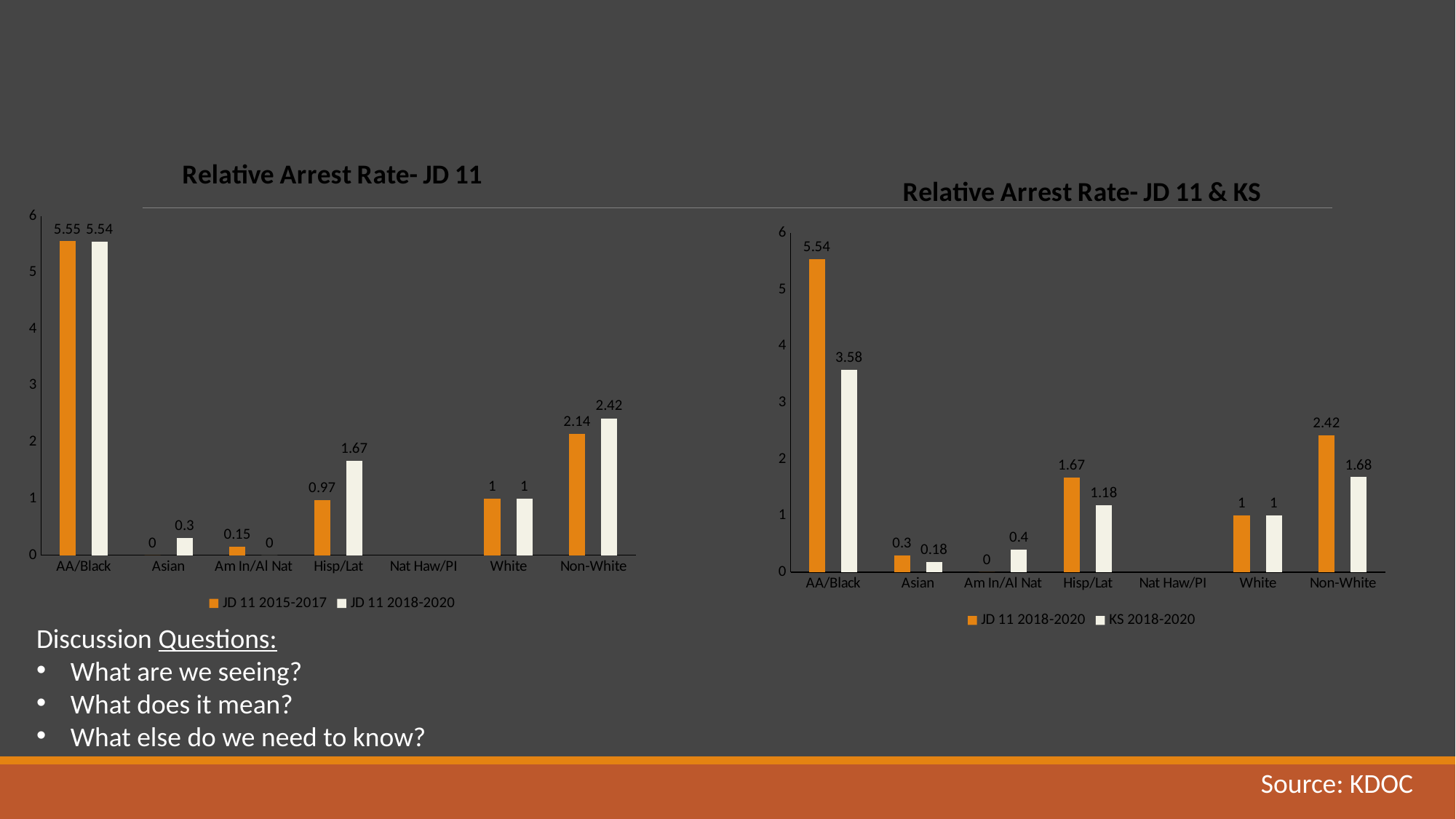
In the 'Relative Arrest Rate- JD 11' chart, how many categories are shown on the x axis? 7 In the 'Relative Arrest Rate- JD 11' chart, what is the value for Hisp/Lat in the JD 11 2018-2020 series? 1.67 In the 'Relative Arrest Rate- JD 11 & KS' chart, which is larger for Non-White: JD 11 2018-2020 or KS 2018-2020? JD 11 2018-2020 What kind of chart is 'Relative Arrest Rate- JD 11 & KS'? Bar chart In the 'Relative Arrest Rate- JD 11' chart, what is the value for AA/Black in the JD 11 2015-2017 series? 5.55 In the 'Relative Arrest Rate- JD 11 & KS' chart, what is the difference between the JD 11 2018-2020 and KS 2018-2020 values for Hisp/Lat? 0.49 In the 'Relative Arrest Rate- JD 11' chart, how many series does the legend list? 2 In the 'Relative Arrest Rate- JD 11 & KS' chart, what is the value for Am In/Al Nat in the KS 2018-2020 series? 0.4 In the 'Relative Arrest Rate- JD 11' chart, which category has the highest value in the JD 11 2018-2020 series? AA/Black In the 'Relative Arrest Rate- JD 11 & KS' chart, what is the value for AA/Black in the KS 2018-2020 series? 3.58 In the 'Relative Arrest Rate- JD 11' chart, what is the difference between the JD 11 2018-2020 and JD 11 2015-2017 values for Non-White? 0.28 In the 'Relative Arrest Rate- JD 11 & KS' chart, which series is shown in orange? JD 11 2018-2020